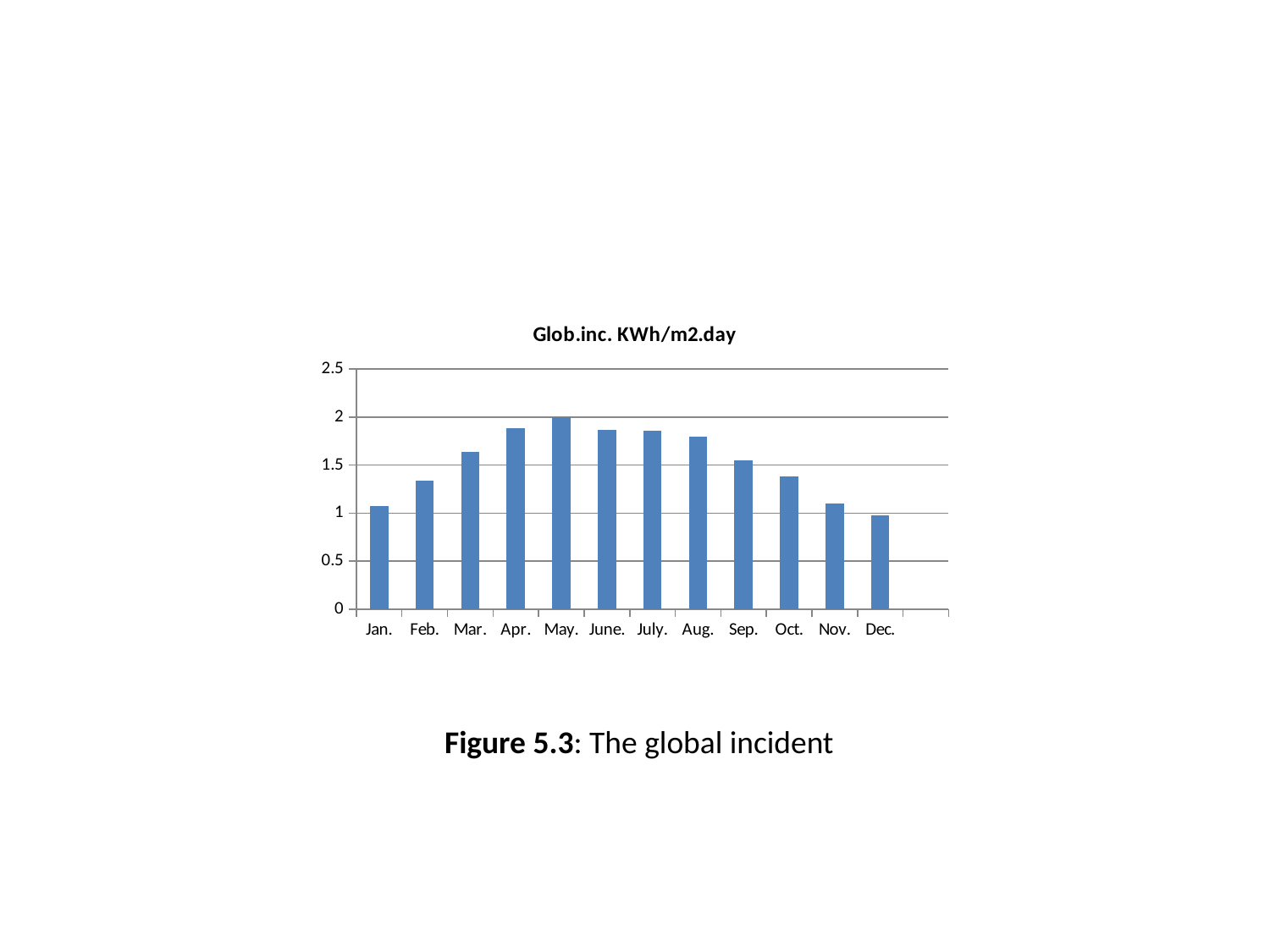
How do the values change from Jan. to May.? They rise What kind of chart is shown on the slide? Bar chart Is the value for Aug. greater or less than 2? less Is the value for Jan. greater or less than 1? greater Which month has the highest value in the chart? May. How many months are shown on the x axis of the chart? 12 What is the title of the chart? Glob.inc. KWh/m2.day Which is larger, the value for Mar. or the value for Feb.? Mar. Is the value for Apr. greater or less than 1.5? greater Which month has the lowest value in the chart? Dec.